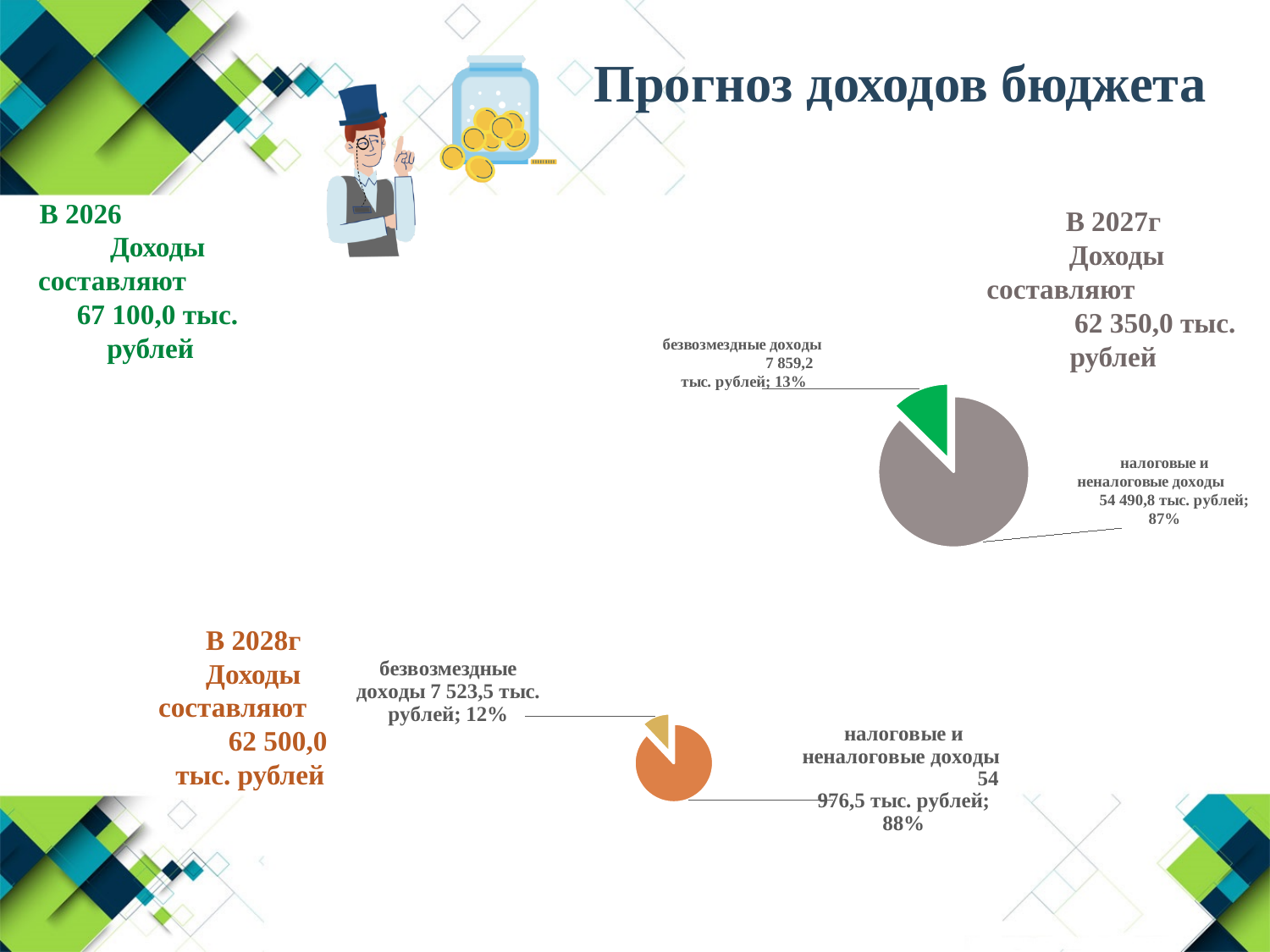
In the lower pie chart (2028), what is the value for безвозмездные доходы? 7 523,5 тыс. рублей In the upper-right pie chart (2027), which category is the largest? налоговые и неналоговые доходы What kind of chart is the upper-right chart (2027)? pie chart In the lower pie chart (2028), what share of the pie is безвозмездные доходы? 12% In the upper-right pie chart (2027), what share of the pie is налоговые и неналоговые доходы? 87% In the upper-right pie chart (2027), what is the value for налоговые и неналоговые доходы? 54 490,8 тыс. рублей How many slices does the lower pie chart (2028) have? 2 In the lower pie chart (2028), which category is the smallest? безвозмездные доходы In the upper-right pie chart (2027), what share of the pie is безвозмездные доходы? 13% In the upper-right pie chart (2027), what is the value for безвозмездные доходы? 7 859,2 тыс. рублей Which is larger: безвозмездные доходы in the upper-right pie chart (2027) or безвозмездные доходы in the lower pie chart (2028)? 2027 (7 859,2 тыс. рублей) In the lower pie chart (2028), what is the value for налоговые и неналоговые доходы? 54 976,5 тыс. рублей